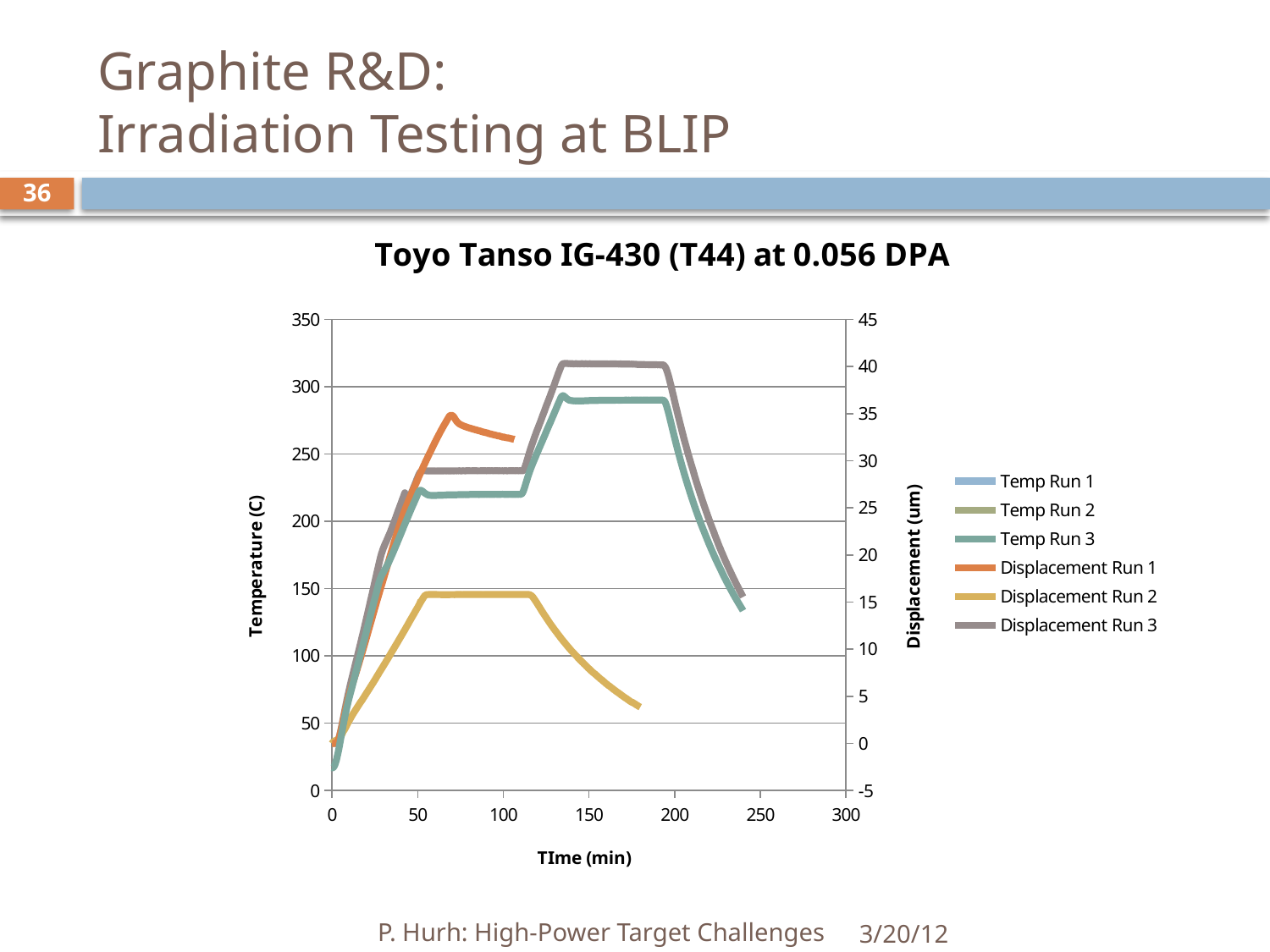
How many series does the legend list? 6 What kind of chart is shown on the slide? line chart Is the first plateau value of Temp Run 3 (between about 55 and 110 min) greater or less than 200 C on the left axis? greater Is the upper plateau value of Displacement Run 3 (between about 135 and 195 min) greater or less than 35 um on the right axis? greater Is the plateau value of Displacement Run 2 (between about 55 and 115 min) greater or less than 20 um on the right axis? less What is the title of the chart? Toyo Tanso IG-430 (T44) at 0.056 DPA After about 115 min, does Displacement Run 2 rise or fall as time increases? fall Which of the three displacement runs reaches the highest displacement value? Displacement Run 3 What is the label of the right-hand vertical axis? Displacement (um) Which reaches a higher plateau displacement: Displacement Run 2 or Displacement Run 3? Displacement Run 3